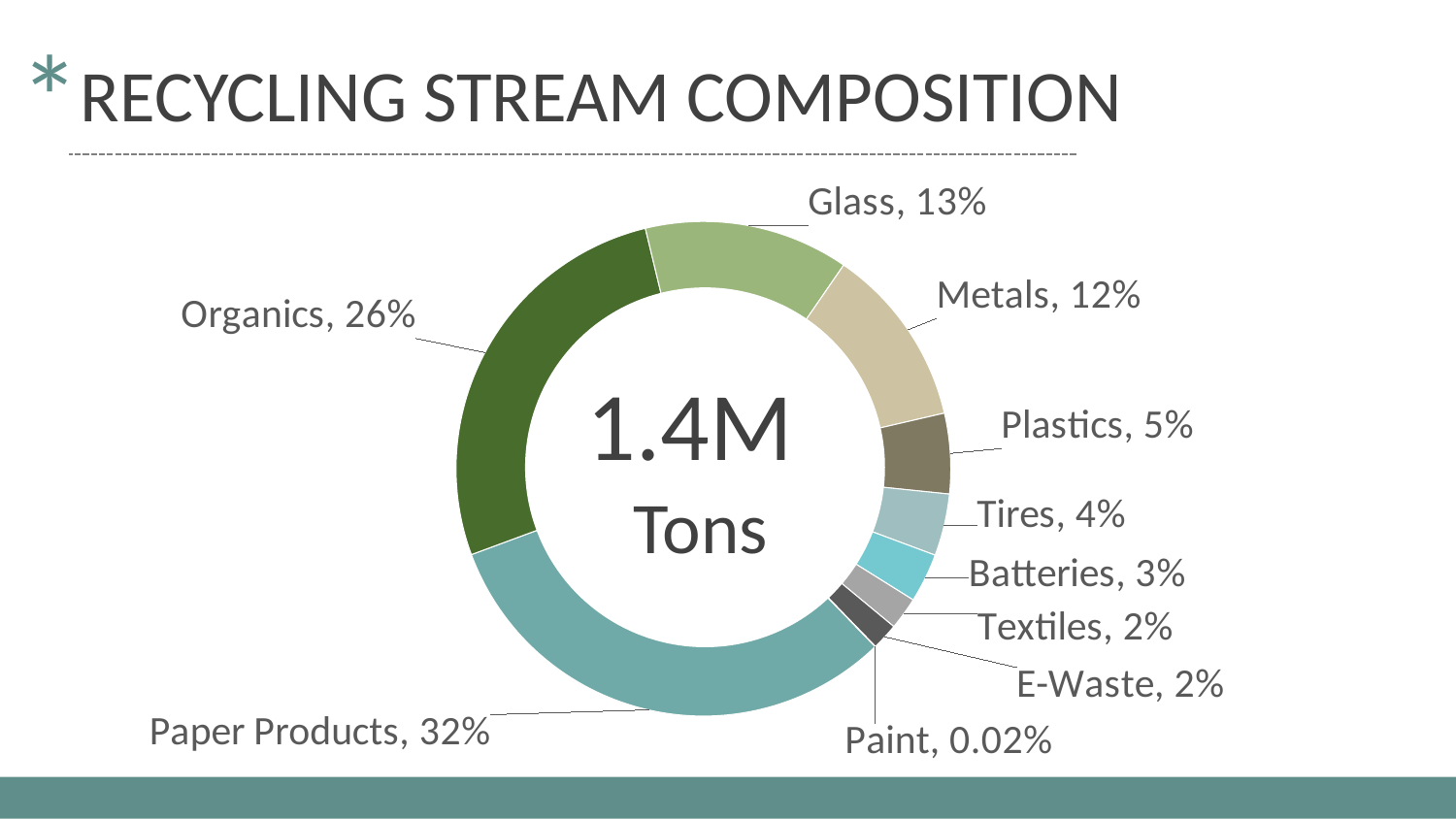
What share of the recycling stream is Paint? 0.02% Which has a larger share, Plastics or Tires? Plastics What share of the recycling stream is Glass? 13% What share of the recycling stream is Organics? 26% What kind of chart is shown on the slide? Pie chart (doughnut) What is the difference in percentage points between Paper Products and Organics? 6 How many categories are shown in the chart? 10 Which category has the largest share of the recycling stream? Paper Products What is the difference in percentage points between Glass and Metals? 1 What total is shown in the centre of the chart? 1.4M Tons Which category has the smallest share of the recycling stream? Paint What share of the recycling stream is Paper Products? 32%